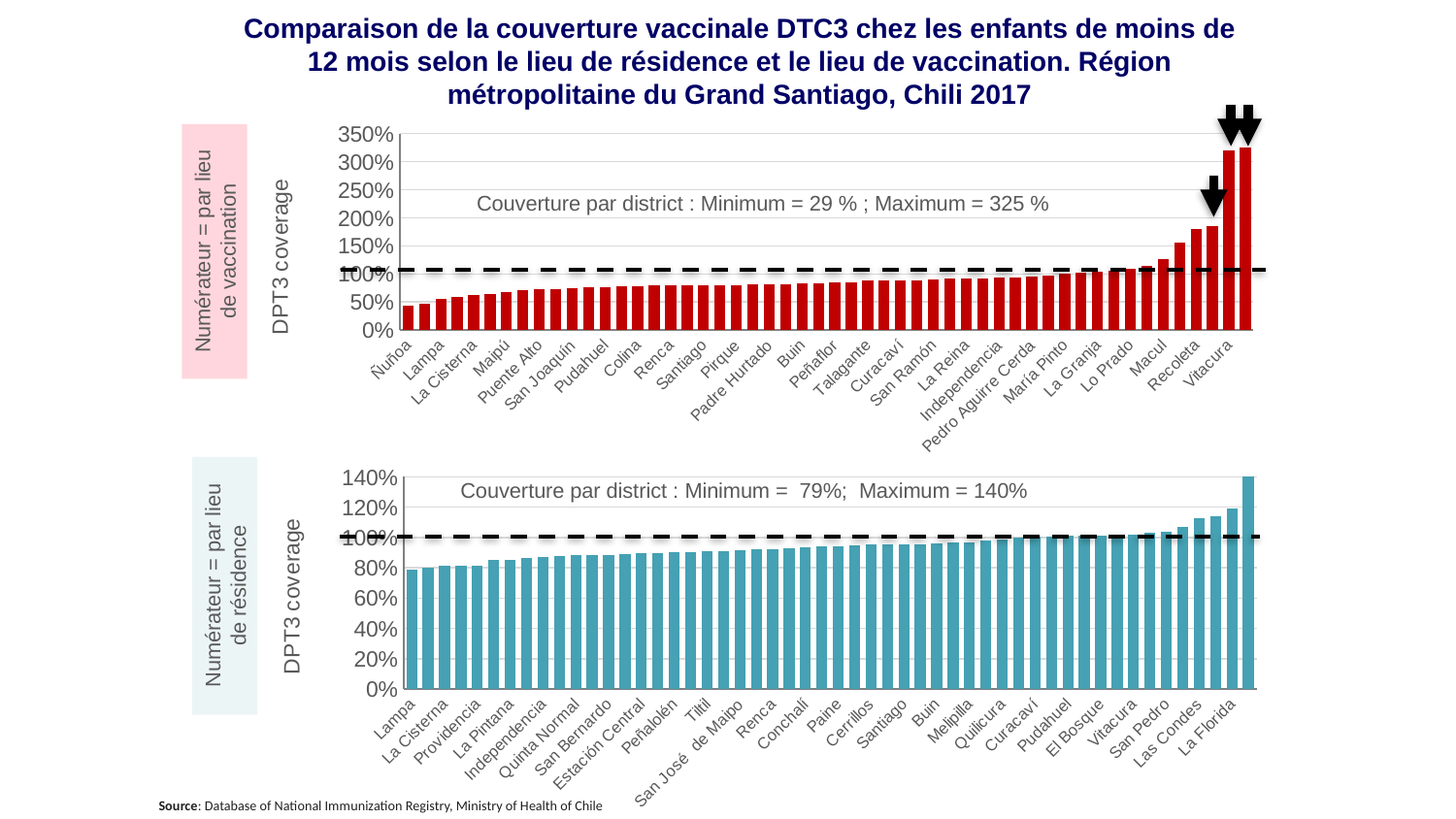
What kind of chart is the top chart (Numérateur = par lieu de vaccination)? bar chart In the bottom chart (par lieu de résidence), do the values rise or fall from left to right along the x axis? rise In the bottom chart (par lieu de résidence), what is the maximum coverage by district stated in the annotation? 140% In the top chart (par lieu de vaccination), which has the larger value, Ñuñoa or Macul? Macul In the top chart (par lieu de vaccination), is the value for Ñuñoa greater or less than 50%? less What is the y-axis label of the bottom chart (par lieu de résidence)? DPT3 coverage In the top chart (par lieu de vaccination), what is the minimum coverage by district stated in the annotation? 29 % In the top chart (par lieu de vaccination), what is the maximum coverage by district stated in the annotation? 325 % In the bottom chart (par lieu de résidence), what is the difference between the stated maximum and minimum coverage by district? 61% In the bottom chart (par lieu de résidence), what is the minimum coverage by district stated in the annotation? 79% In the bottom chart (par lieu de résidence), is the value for Providencia greater or less than 100%? less In the top chart (par lieu de vaccination), is the value for Macul greater or less than 100%? greater